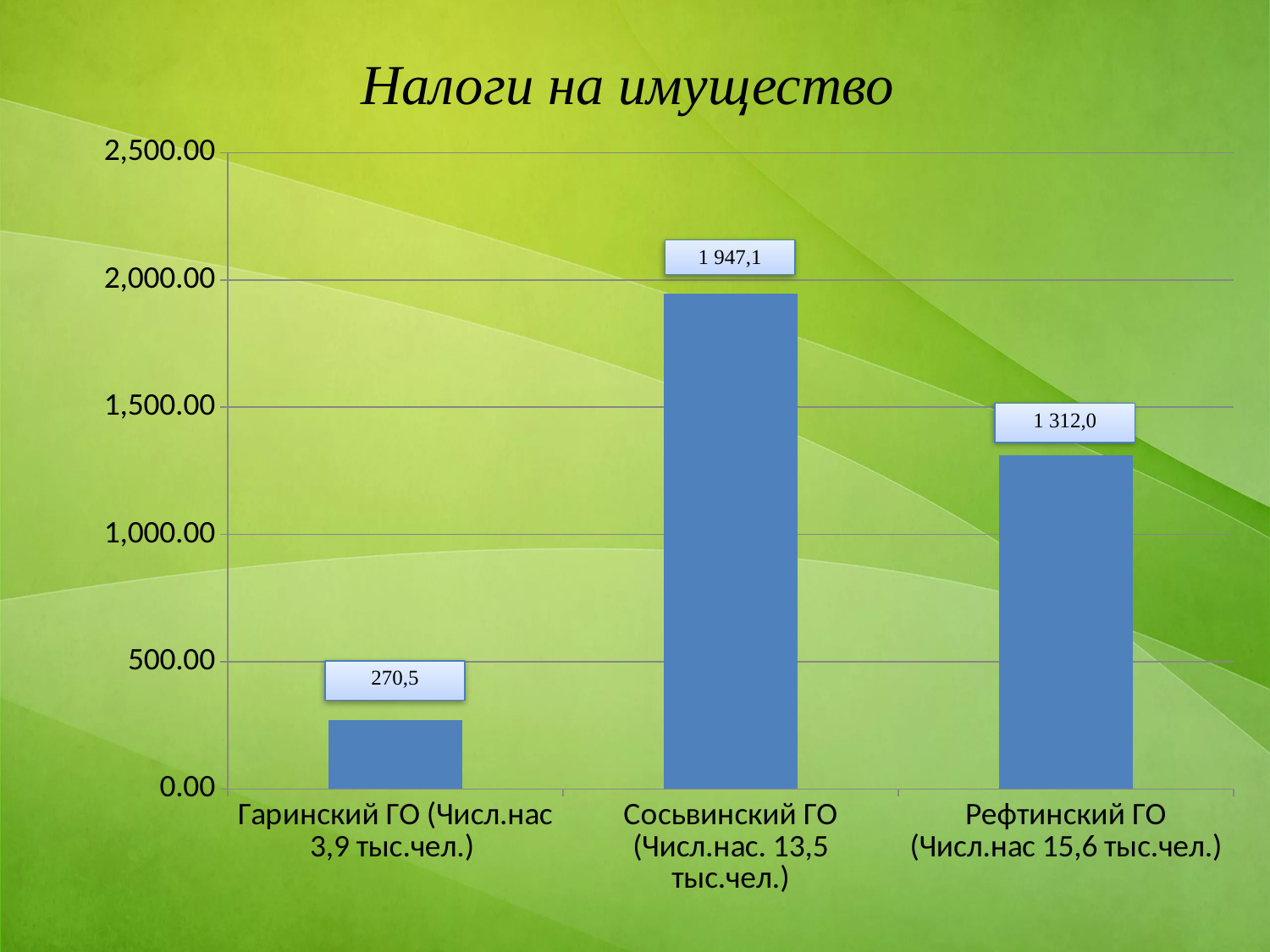
What kind of chart is shown on the slide? bar chart How many categories are shown in the chart? 3 Which category has the highest value? Сосьвинский ГО Which is larger, the value for Рефтинский ГО or the value for Гаринский ГО? Рефтинский ГО Is the value for Рефтинский ГО greater or less than 1,500.00? less What is the value for Сосьвинский ГО? 1 947,1 What is the title of the chart? Налоги на имущество What is the difference between the values for Рефтинский ГО and Гаринский ГО? 1 041,5 What is the difference between the values for Сосьвинский ГО and Рефтинский ГО? 635,1 What is the value for Гаринский ГО? 270,5 What is the value for Рефтинский ГО? 1 312,0 Which category has the lowest value? Гаринский ГО